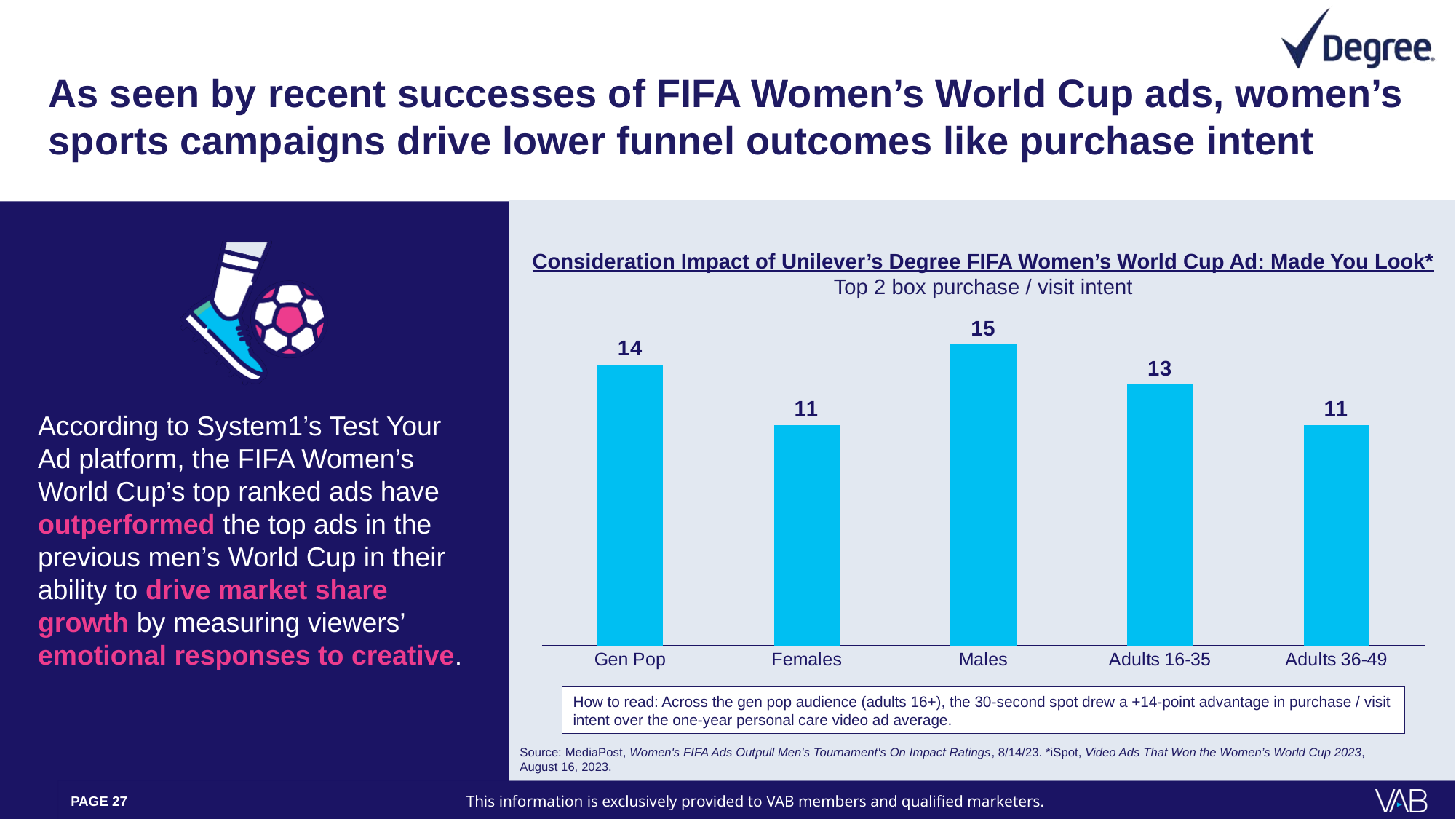
What is the value for Gen Pop? 14 What is the value for Females? 11 What is the value for Adults 16-35? 13 How many categories are shown on the chart? 5 What is the difference between the values for Males and Females? 4 What is the title of the chart? Consideration Impact of Unilever's Degree FIFA Women's World Cup Ad: Made You Look* What is the subtitle of the chart? Top 2 box purchase / visit intent What is the difference between the values for Gen Pop and Adults 36-49? 3 Which category has the highest value? Males Which is larger, the value for Adults 16-35 or the value for Adults 36-49? Adults 16-35 What kind of chart is shown on the slide? Bar chart What is the value for Males? 15